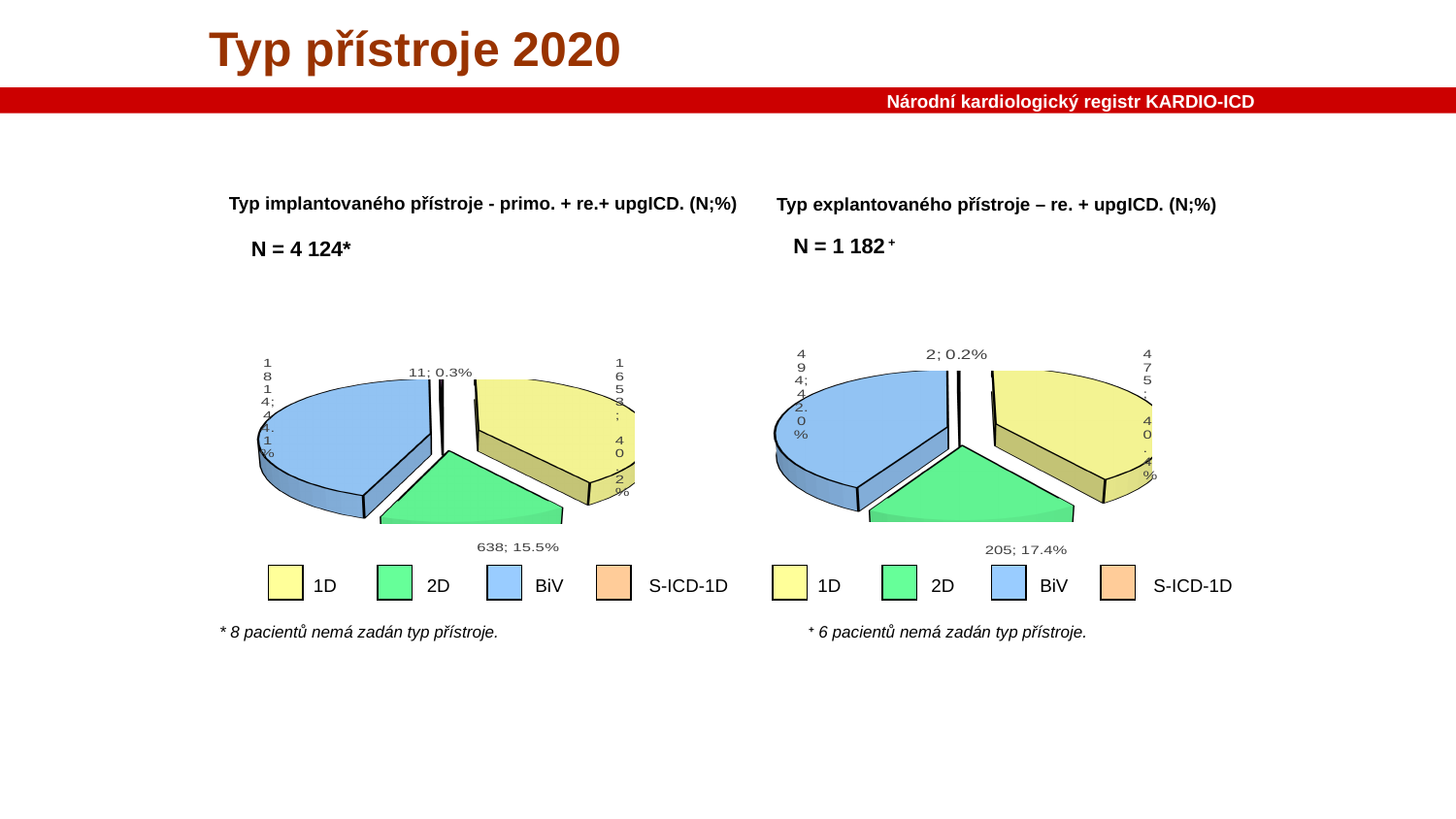
How many entries does the legend of the left chart list? 4 In the right chart (Typ explantovaného přístroje), which device type has the smallest slice? S-ICD-1D In the right chart (Typ explantovaného přístroje), what is the data label for the 2D slice? 205; 17.4% In the left chart (Typ implantovaného přístroje), which device type has the smallest slice? S-ICD-1D In the left chart (Typ implantovaného přístroje), what is the data label for the S-ICD-1D slice? 11; 0.3% In the right chart (Typ explantovaného přístroje), what is the difference in count between the 2D slice and the S-ICD-1D slice? 203 In the left chart (Typ implantovaného přístroje), which device type has the largest slice? BiV Is the share of 2D larger in the left chart (Typ implantovaného přístroje) or in the right chart (Typ explantovaného přístroje)? right chart In the right chart (Typ explantovaného přístroje), what is the data label for the S-ICD-1D slice? 2; 0.2% What kind of chart is the left chart, 'Typ implantovaného přístroje'? pie chart In the left chart (Typ implantovaného přístroje), what is the data label for the 2D slice? 638; 15.5% What is the N value stated for the left chart (Typ implantovaného přístroje)? N = 4 124*